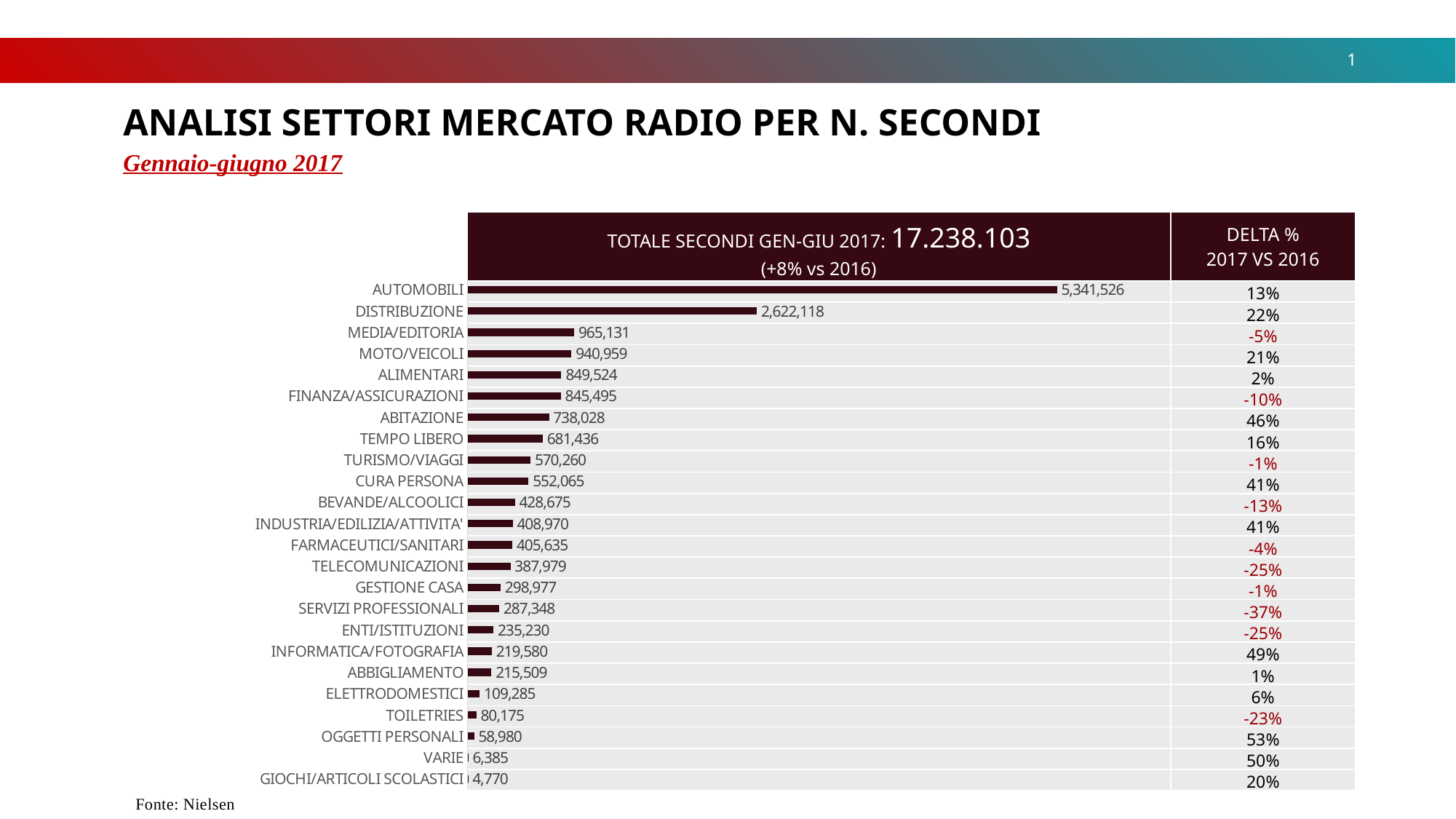
Which category has the lowest value? GIOCHI/ARTICOLI SCOLASTICI Which is larger, the value for ABITAZIONE or the value for TEMPO LIBERO? ABITAZIONE Which category has the highest value? AUTOMOBILI What is the difference between the values for MEDIA/EDITORIA and MOTO/VEICOLI? 24,172 What is the difference between the values for AUTOMOBILI and DISTRIBUZIONE? 2,719,408 What is the value for OGGETTI PERSONALI? 58,980 How many categories are shown in the chart? 24 What kind of chart is shown on the slide? Bar chart What is the value for TELECOMUNICAZIONI? 387,979 Which is larger, the value for TOILETRIES or the value for ELETTRODOMESTICI? ELETTRODOMESTICI What is the value for AUTOMOBILI? 5,341,526 What total number of seconds for Gen-Giu 2017 is shown in the chart header? 17.238.103